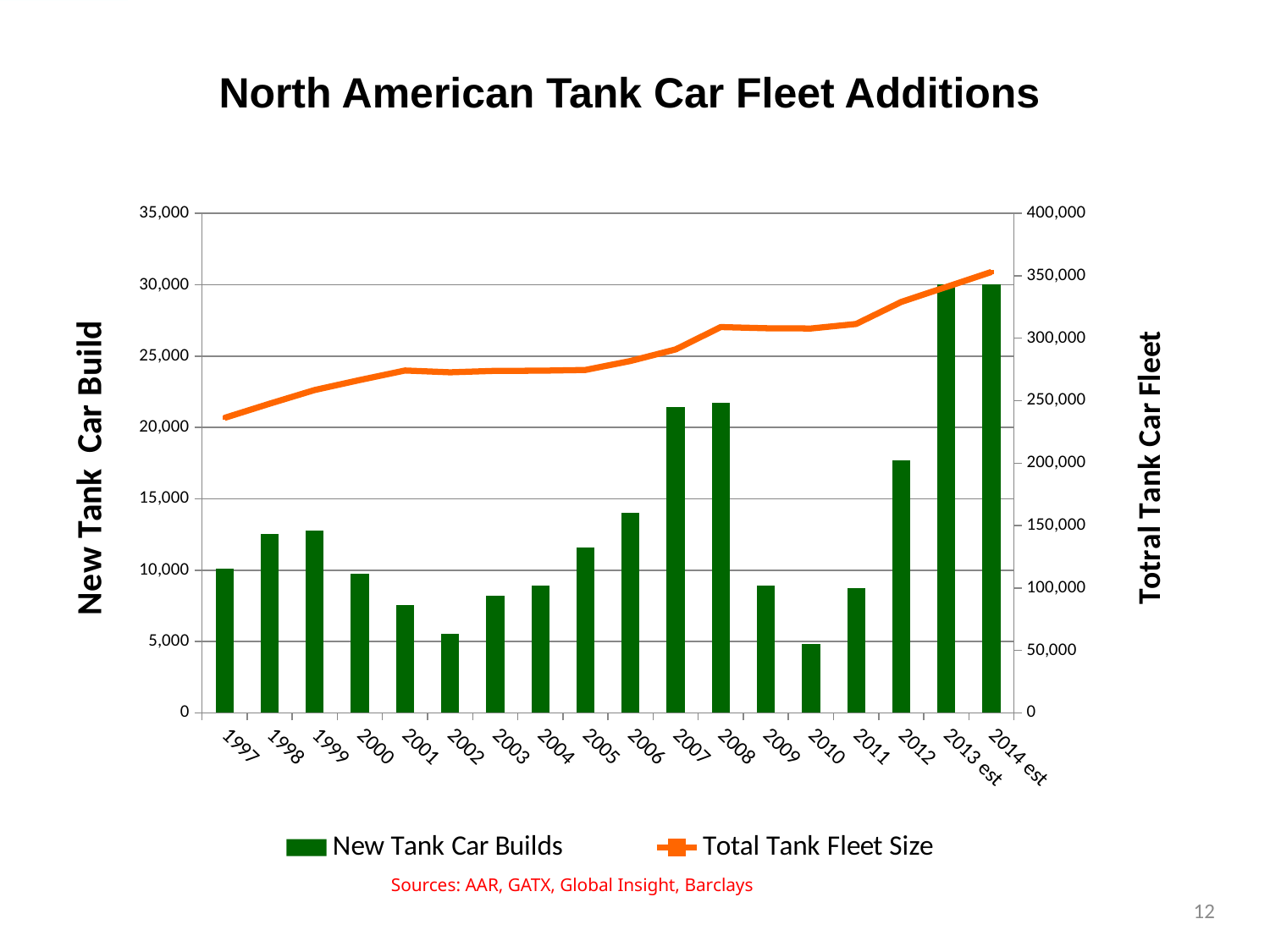
In which year is the Total Tank Fleet Size highest? 2014 est Which year has the larger value for New Tank Car Builds, 2007 or 2012? 2007 Is the value for New Tank Car Builds in 2007 greater or less than 20,000? greater Which year has the lowest value for New Tank Car Builds? 2010 Is the value for New Tank Car Builds in 2012 greater or less than 15,000? greater Does the Total Tank Fleet Size line generally rise or fall from 1997 to 2014 est? rise What is the title of the chart? North American Tank Car Fleet Additions How many series does the legend list? 2 How many years are shown along the x axis? 18 What kind of chart is shown on the slide? A combination bar and line chart Is the Total Tank Fleet Size in 2012 greater or less than 300,000? greater